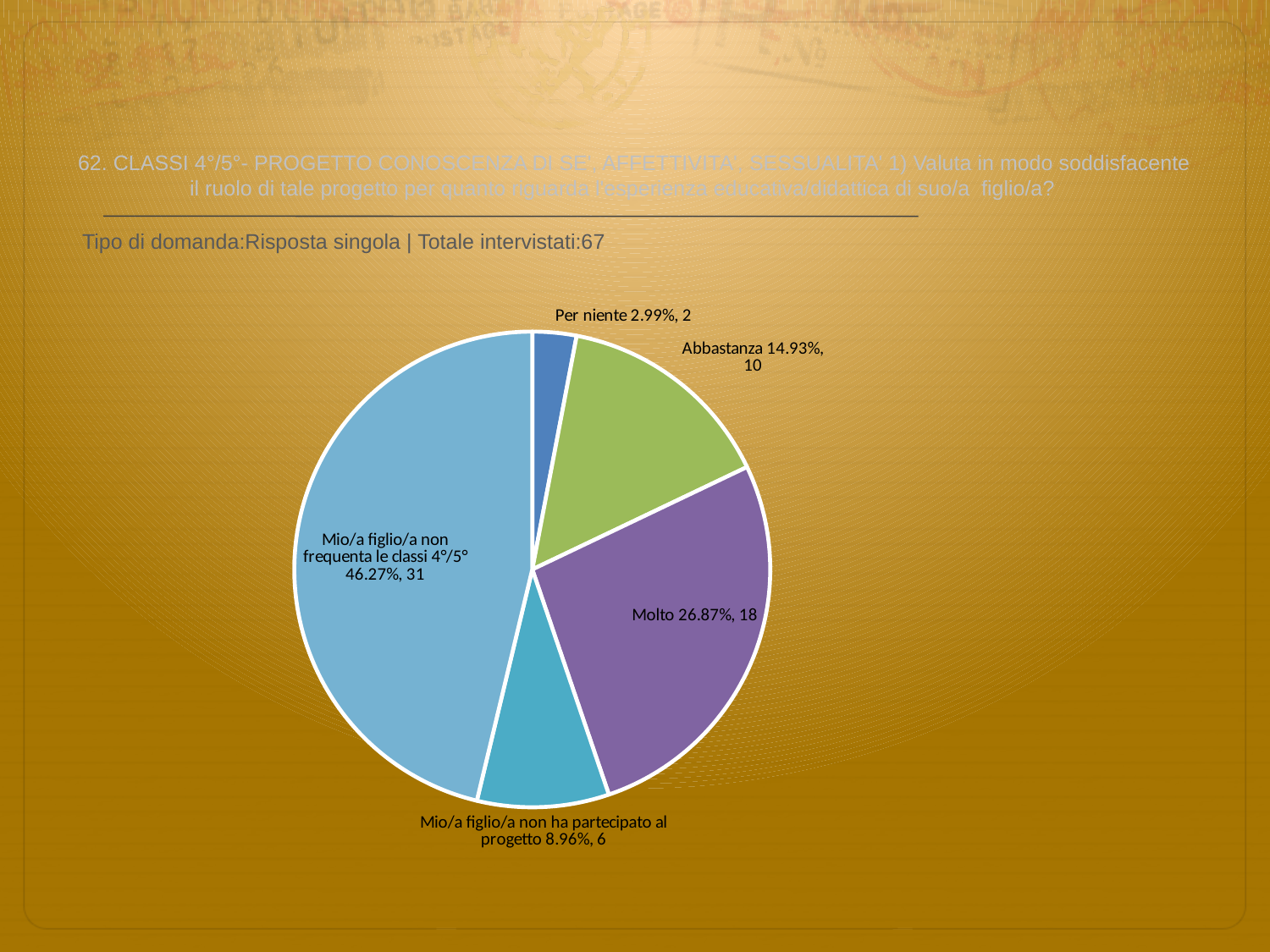
What is the difference in count between 'Molto' and 'Abbastanza'? 8 What is the count for 'Per niente'? 2 What percentage share does 'Mio/a figlio/a non ha partecipato al progetto' have? 8.96% Which is larger, the count for 'Mio/a figlio/a non ha partecipato al progetto' or the count for 'Abbastanza'? Abbastanza Which category has the largest slice of the pie? Mio/a figlio/a non frequenta le classi 4°/5° What colour is the 'Molto' slice? purple What kind of chart is shown on the slide? pie chart What percentage share does the 'Molto' slice have? 26.87% What is the total number of respondents stated on the slide? 67 How many slices does the pie chart have? 5 How many respondents answered 'Abbastanza'? 10 Which category has the smallest slice of the pie? Per niente